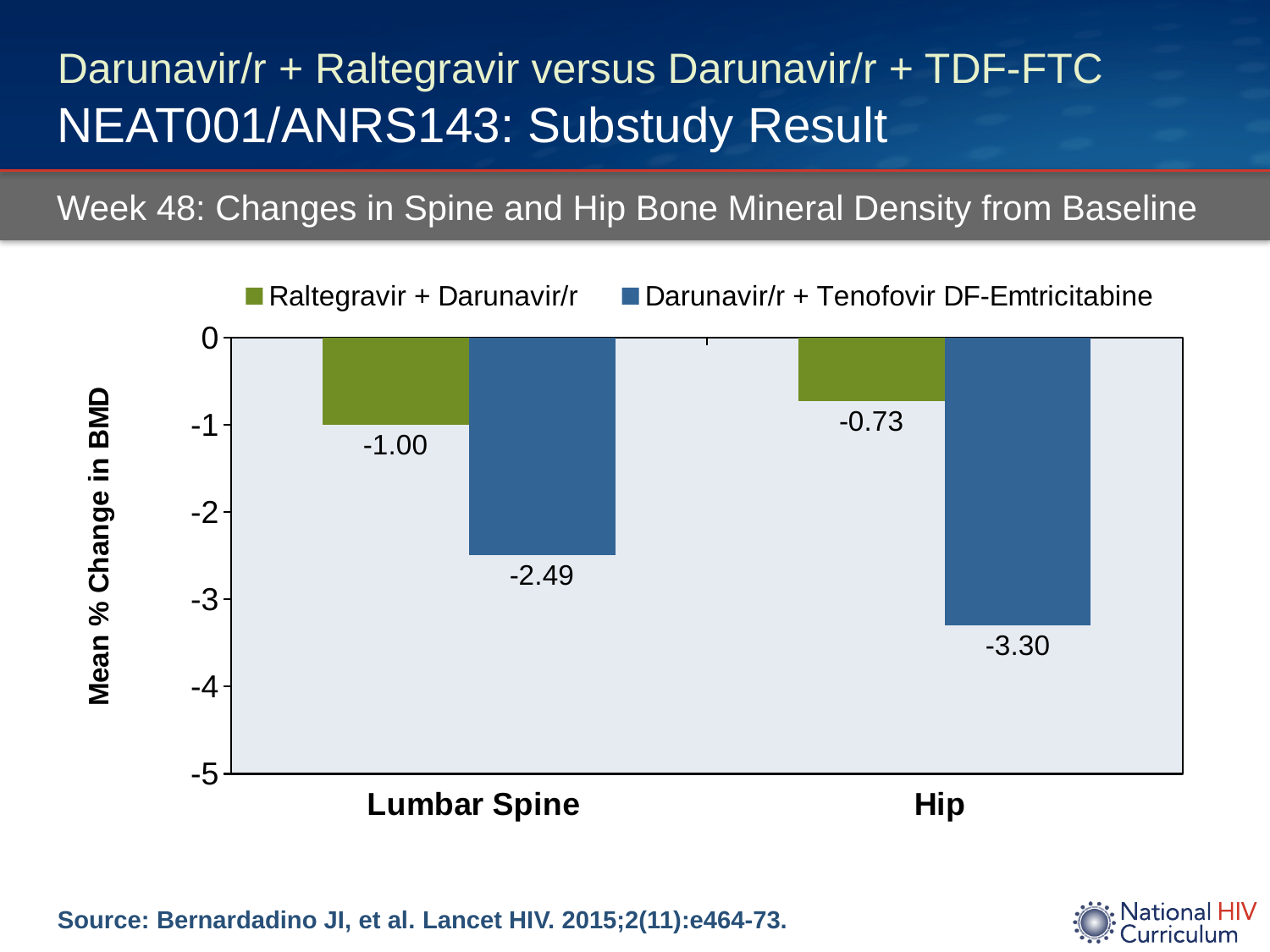
Which arm had a larger decrease in BMD at the Hip? Darunavir/r + Tenofovir DF-Emtricitabine What is the mean % change in BMD for Raltegravir + Darunavir/r at the Hip? -0.73 What is the mean % change in BMD for Darunavir/r + Tenofovir DF-Emtricitabine at the Hip? -3.30 What kind of chart is shown on the slide? Bar chart Which bar shows the smallest decrease in BMD? Raltegravir + Darunavir/r at the Hip What is the difference between the Hip values for the two treatment arms? 2.57 What is the mean % change in BMD for Raltegravir + Darunavir/r at the Lumbar Spine? -1.00 Which bar shows the largest decrease in BMD? Darunavir/r + Tenofovir DF-Emtricitabine at the Hip How many series does the legend list? 2 How many categories are shown on the x axis? 2 What is the mean % change in BMD for Darunavir/r + Tenofovir DF-Emtricitabine at the Lumbar Spine? -2.49 What is the difference between the Lumbar Spine values for the two treatment arms? 1.49